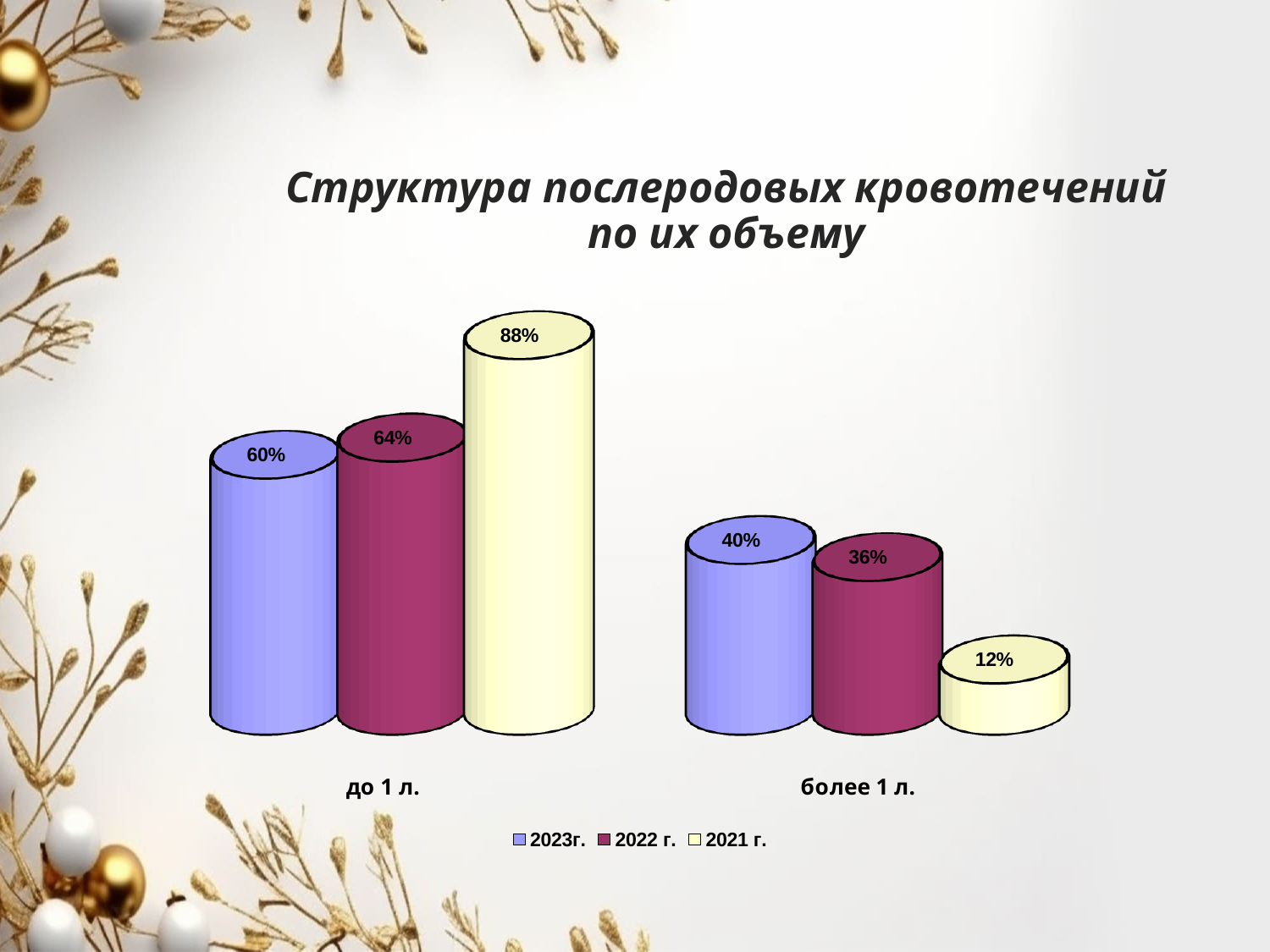
What is the value for 2021 г. in the category "до 1 л."? 88% What is the difference between the 2023г. and 2022 г. values in the category "более 1 л."? 4% How many categories are shown on the x axis? 2 What kind of chart is shown on the slide? Bar chart What is the difference between the 2021 г. values for "до 1 л." and "более 1 л."? 76% What is the title of the chart? Структура послеродовых кровотечений по их объему Which is larger: the 2023г. value or the 2022 г. value in the category "до 1 л."? 2022 г. Which series has the highest value in the category "до 1 л."? 2021 г. How many series does the legend list? 3 What is the value for 2022 г. in the category "до 1 л."? 64% What is the value for 2023г. in the category "более 1 л."? 40% Which series has the lowest value in the category "более 1 л."? 2021 г.